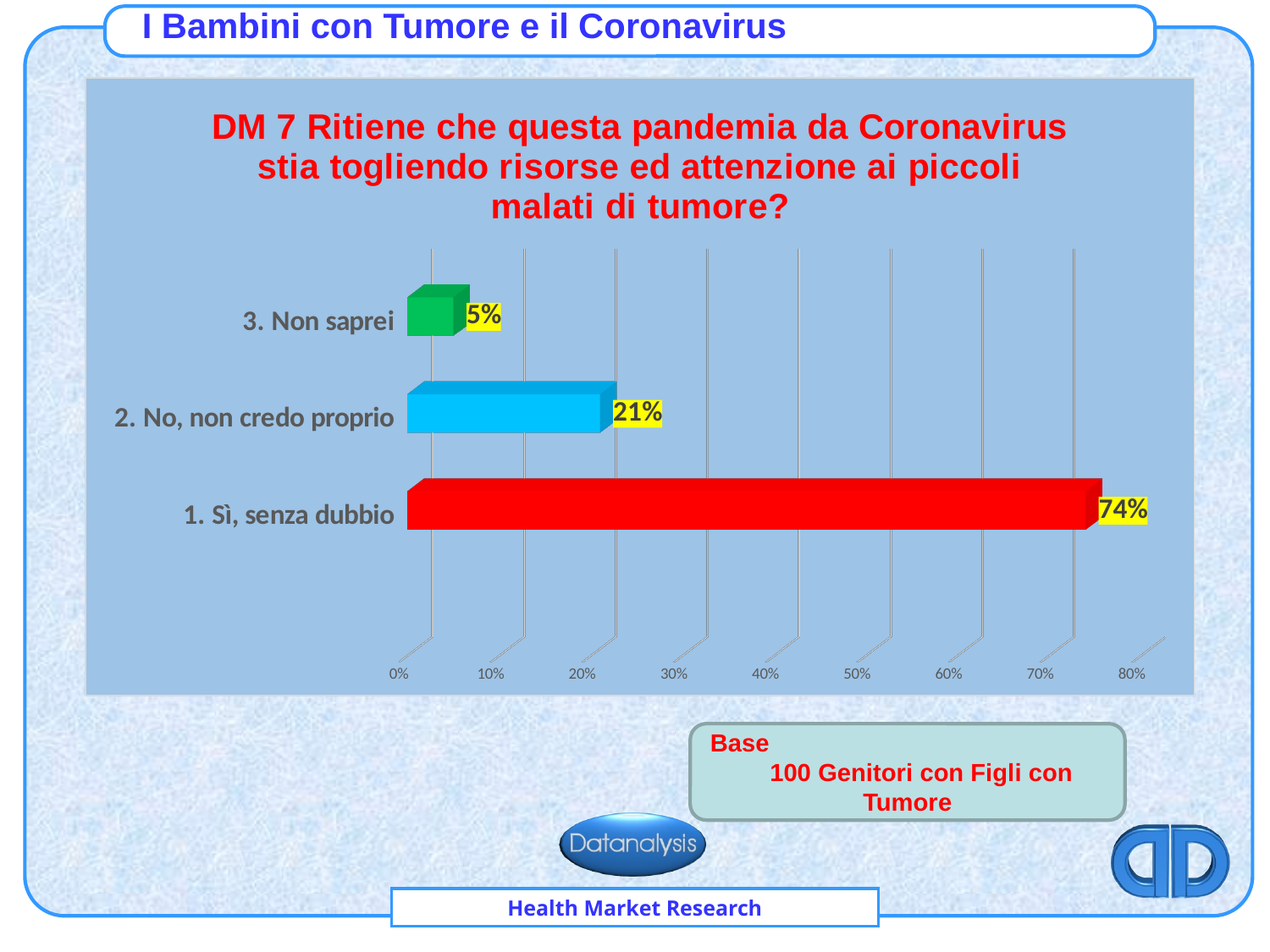
Which category has the lowest value? 3. Non saprei What is the difference between the values for "2. No, non credo proprio" and "3. Non saprei"? 16% Which is larger, the value for "2. No, non credo proprio" or the value for "3. Non saprei"? 2. No, non credo proprio What colour is the bar for "1. Sì, senza dubbio"? red What is the value for "3. Non saprei"? 5% What is the value for "2. No, non credo proprio"? 21% Which category has the highest value? 1. Sì, senza dubbio Is the value for "1. Sì, senza dubbio" greater or less than 70%? greater What kind of chart is shown on the slide? bar chart How many categories are shown in the chart? 3 What is the value for "1. Sì, senza dubbio"? 74% What is the difference between the values for "1. Sì, senza dubbio" and "2. No, non credo proprio"? 53%